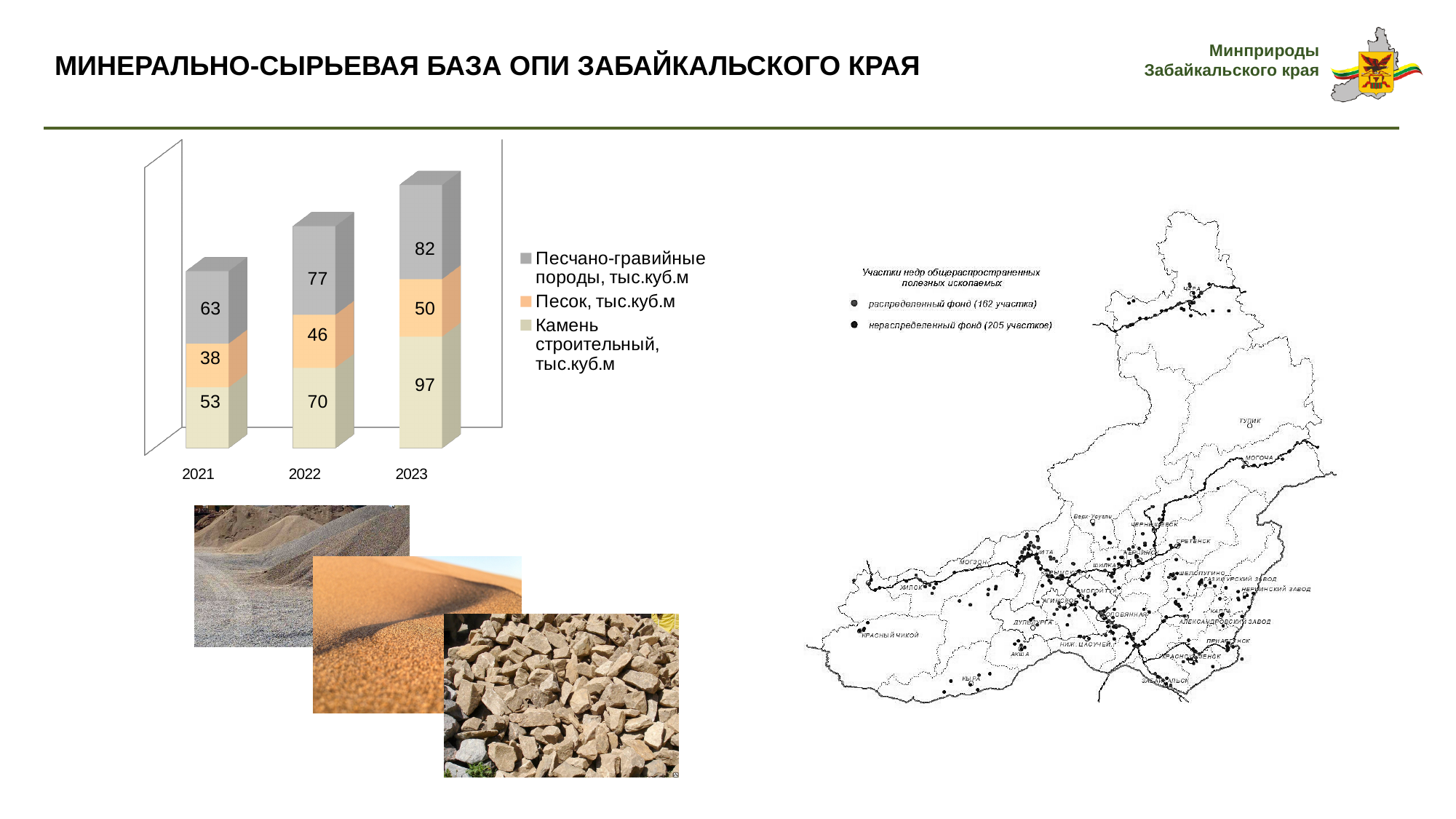
What is the value for Камень строительный, тыс.куб.м in 2023? 97 In which year is the value for Песок, тыс.куб.м the lowest? 2021 Do the values for Камень строительный, тыс.куб.м rise or fall from 2021 to 2023? Rise Which is larger in 2022: Песчано-гравийные породы or Камень строительный? Песчано-гравийные породы What is the value for Песок, тыс.куб.м in 2022? 46 What is the value for Песчано-гравийные породы, тыс.куб.м in 2021? 63 How many years are shown on the x axis of the chart? 3 What is the difference between the Песчано-гравийные породы values for 2023 and 2021? 19 What kind of chart is shown on the slide? Stacked bar chart How many series does the chart legend list? 3 What is the total of the stacked bar for 2023? 229 In which year is the value for Камень строительный, тыс.куб.м the highest? 2023